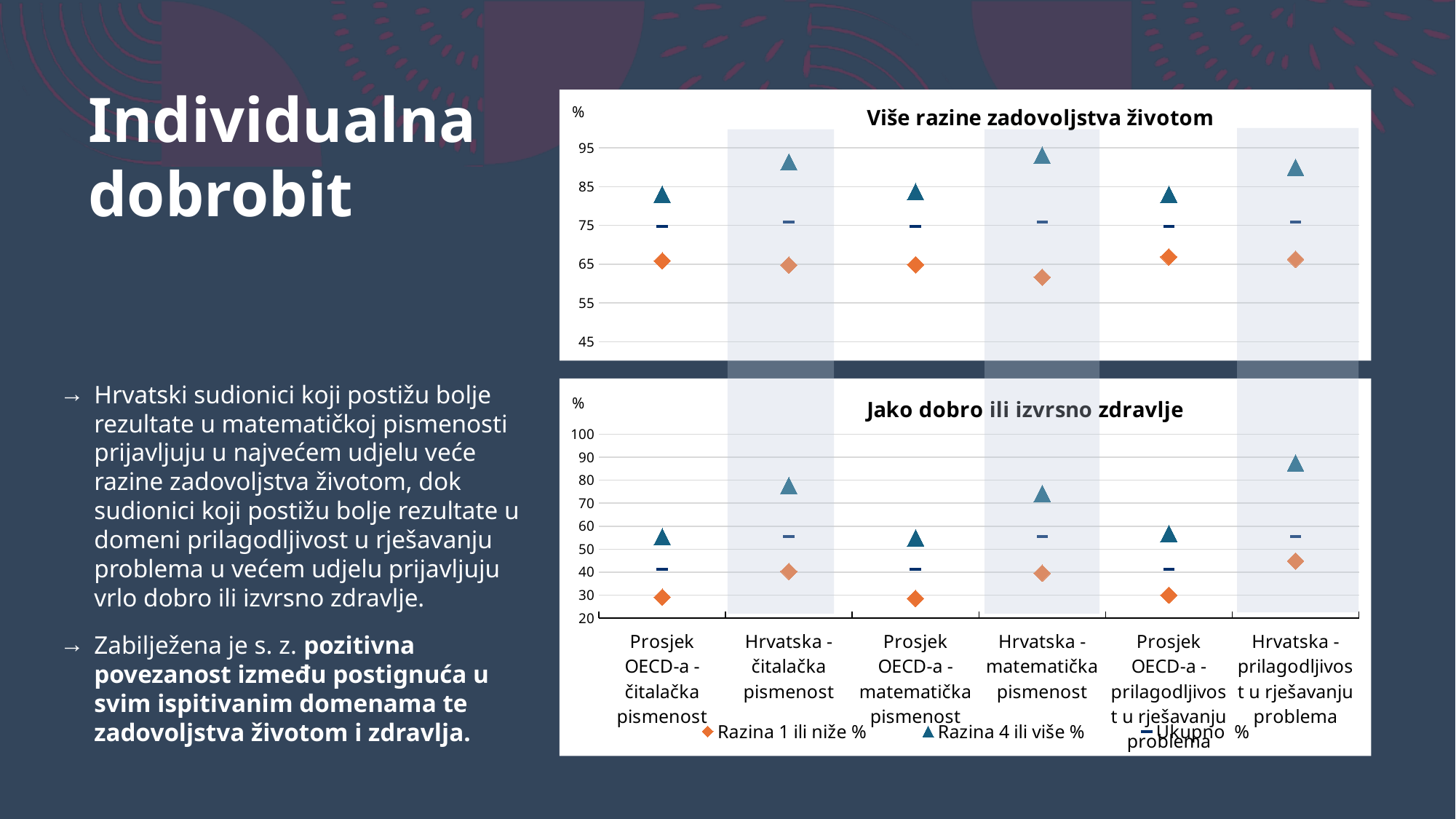
In the chart titled "Jako dobro ili izvrsno zdravlje", which is larger: the "Razina 4 ili više %" value for "Hrvatska - prilagodljivost u rješavanju problema" or for "Hrvatska - čitalačka pismenost"? Hrvatska - prilagodljivost u rješavanju problema In the chart titled "Jako dobro ili izvrsno zdravlje", is the value of "Razina 4 ili više %" for "Hrvatska - prilagodljivost u rješavanju problema" greater or less than 80? greater In the chart titled "Više razine zadovoljstva životom", is the value of "Razina 1 ili niže %" for "Prosjek OECD-a - čitalačka pismenost" greater or less than 75? less In the chart titled "Više razine zadovoljstva životom", is the value of "Razina 4 ili više %" for "Hrvatska - čitalačka pismenost" greater or less than 85? greater In the chart titled "Više razine zadovoljstva životom", which category has the lowest value for "Razina 1 ili niže %"? Hrvatska - matematička pismenost In the chart titled "Jako dobro ili izvrsno zdravlje", which category has the highest value for "Razina 1 ili niže %"? Hrvatska - prilagodljivost u rješavanju problema What kind of chart is the chart titled "Jako dobro ili izvrsno zdravlje"? scatter chart In the chart titled "Jako dobro ili izvrsno zdravlje", how many categories are shown on the x axis? 6 In the chart titled "Jako dobro ili izvrsno zdravlje", which category has the highest value for "Razina 4 ili više %"? Hrvatska - prilagodljivost u rješavanju problema What is the title of the top chart on the slide? Više razine zadovoljstva životom